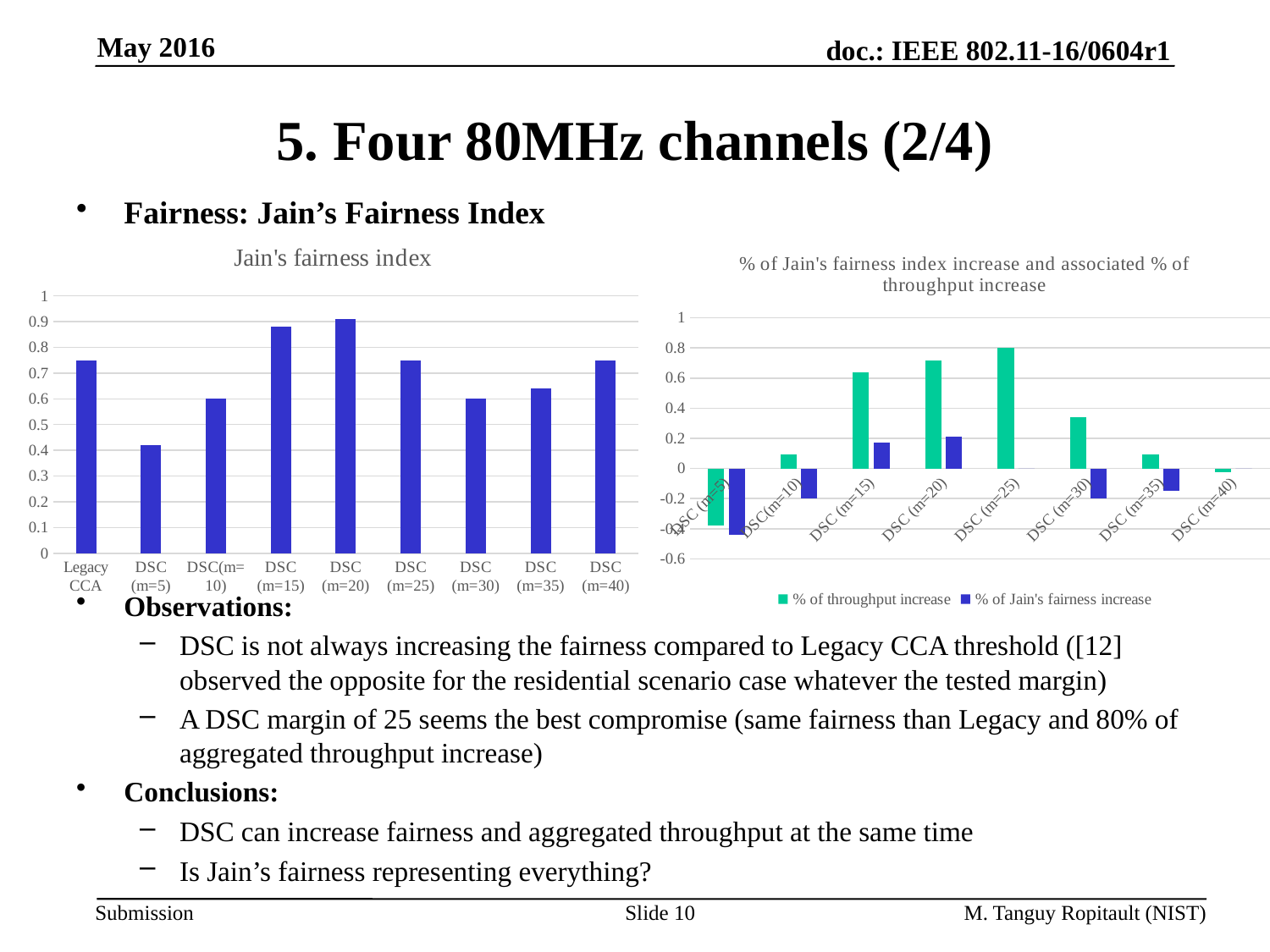
In the chart on the right titled '% of Jain's fairness index increase and associated % of throughput increase', how many series does the legend list? 2 In the 'Jain's fairness index' chart on the left, which category has the highest value? DSC (m=20) In the chart on the right, which category has the highest '% of throughput increase'? DSC (m=25) In the 'Jain's fairness index' chart on the left, is the value for Legacy CCA greater or less than 0.7? greater In the chart on the right, what are the two series named in the legend? % of throughput increase and % of Jain's fairness increase In the 'Jain's fairness index' chart on the left, which is larger: the value for DSC (m=15) or DSC (m=35)? DSC (m=15) What kind of chart is the 'Jain's fairness index' chart on the left? bar chart In the 'Jain's fairness index' chart on the left, which category has the lowest value? DSC (m=5) In the 'Jain's fairness index' chart on the left, how many categories are shown on the x axis? 9 In the 'Jain's fairness index' chart on the left, is the value for DSC (m=5) greater or less than 0.5? less In the chart on the right, is the '% of throughput increase' for DSC (m=15) greater or less than 0.6? greater